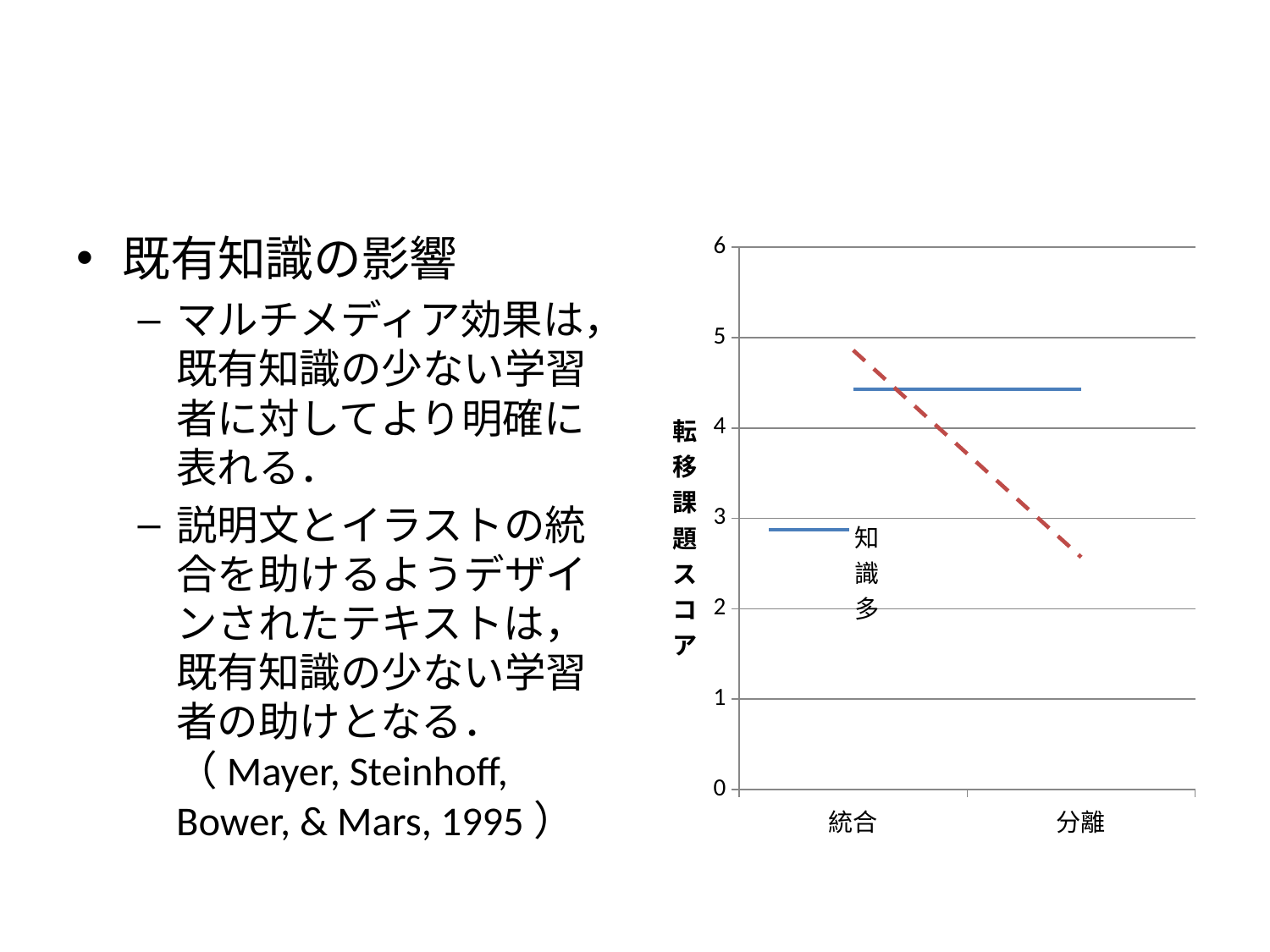
At 分離, which line has the higher value, the solid blue line (知識多) or the dashed red line? the solid blue line (知識多) What are the two categories on the x axis of the chart? 統合 and 分離 What kind of chart is shown on the slide? line chart How many categories are shown on the x axis of the chart? 2 At 統合, which line has the higher value, the solid blue line (知識多) or the dashed red line? the dashed red line What is the title of the vertical axis of the chart? 転移課題スコア Is the value of the dashed red line at 分離 greater or less than 3? less Does the solid blue line (知識多) rise, fall, or stay flat from 統合 to 分離? stay flat Does the dashed red line rise or fall from 統合 to 分離? fall Is the value of the solid blue line (知識多) at 統合 greater or less than 4? greater Is the value of the solid blue line (知識多) at 分離 greater or less than 5? less